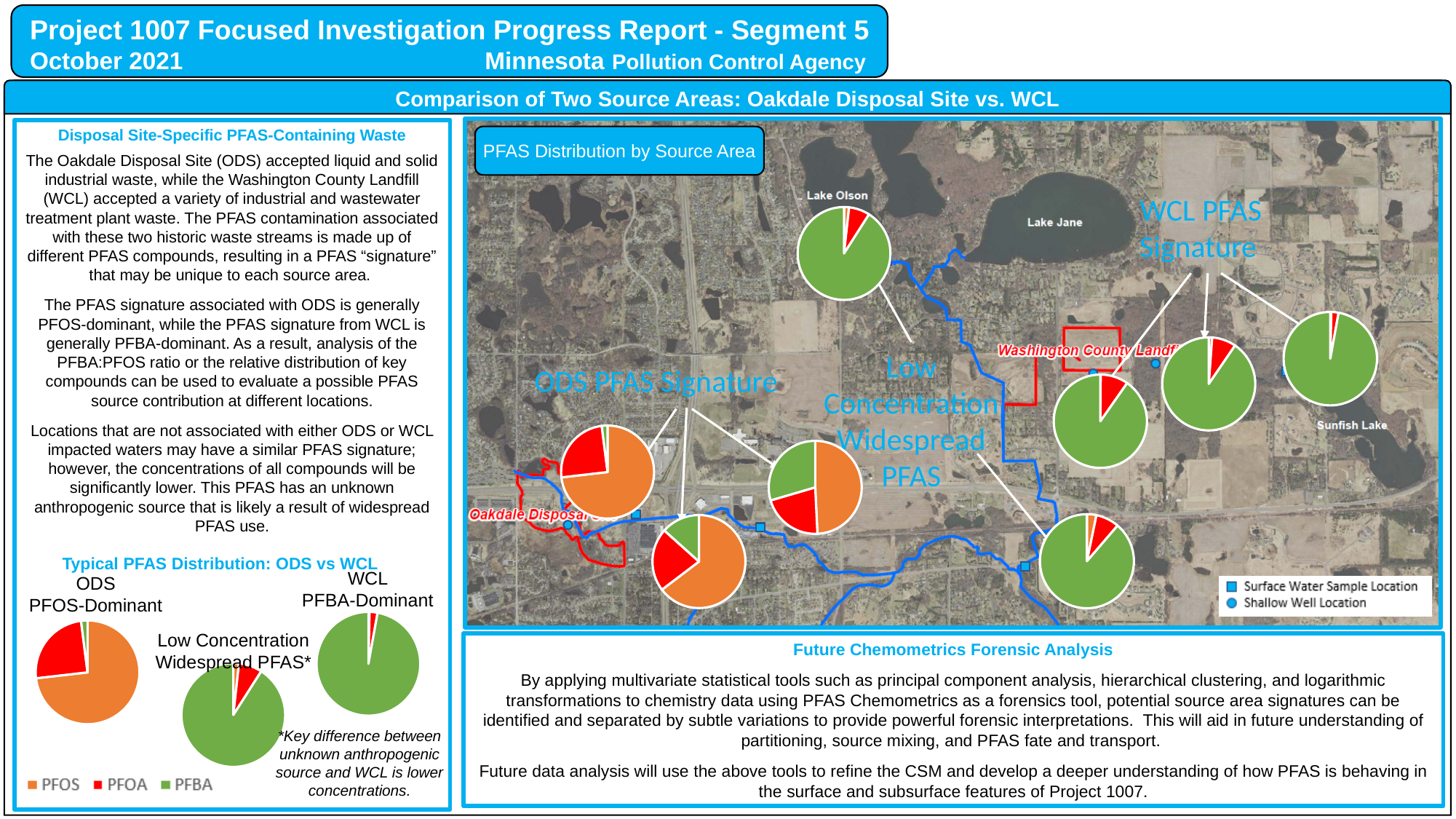
In the 'Typical PFAS Distribution: ODS vs WCL' charts, which compound has the largest slice in the Low Concentration Widespread PFAS pie? PFBA In the 'Typical PFAS Distribution: ODS vs WCL' charts, what colour represents PFBA in the legend? Green In the WCL pie of the 'Typical PFAS Distribution: ODS vs WCL' charts, which slice is larger, PFBA or PFOA? PFBA In the 'Typical PFAS Distribution: ODS vs WCL' charts, which compound has the smallest slice in the WCL pie? PFOS In the 'Typical PFAS Distribution: ODS vs WCL' charts, what colour represents PFOS in the legend? Orange How many pie charts are shown in the 'Typical PFAS Distribution: ODS vs WCL' section? 3 In the ODS pie of the 'Typical PFAS Distribution: ODS vs WCL' charts, which slice is larger, PFOS or PFOA? PFOS In the 'Typical PFAS Distribution: ODS vs WCL' charts, which compound has the largest slice in the ODS pie? PFOS In the 'Typical PFAS Distribution: ODS vs WCL' charts, how many compounds does the legend list? 3 In the 'Typical PFAS Distribution: ODS vs WCL' charts, which compound has the largest slice in the WCL pie? PFBA In the 'Typical PFAS Distribution: ODS vs WCL' charts, what kind of chart is used to show the PFAS distribution? Pie chart In the 'Typical PFAS Distribution: ODS vs WCL' charts, which compound has the smallest slice in the ODS pie? PFBA